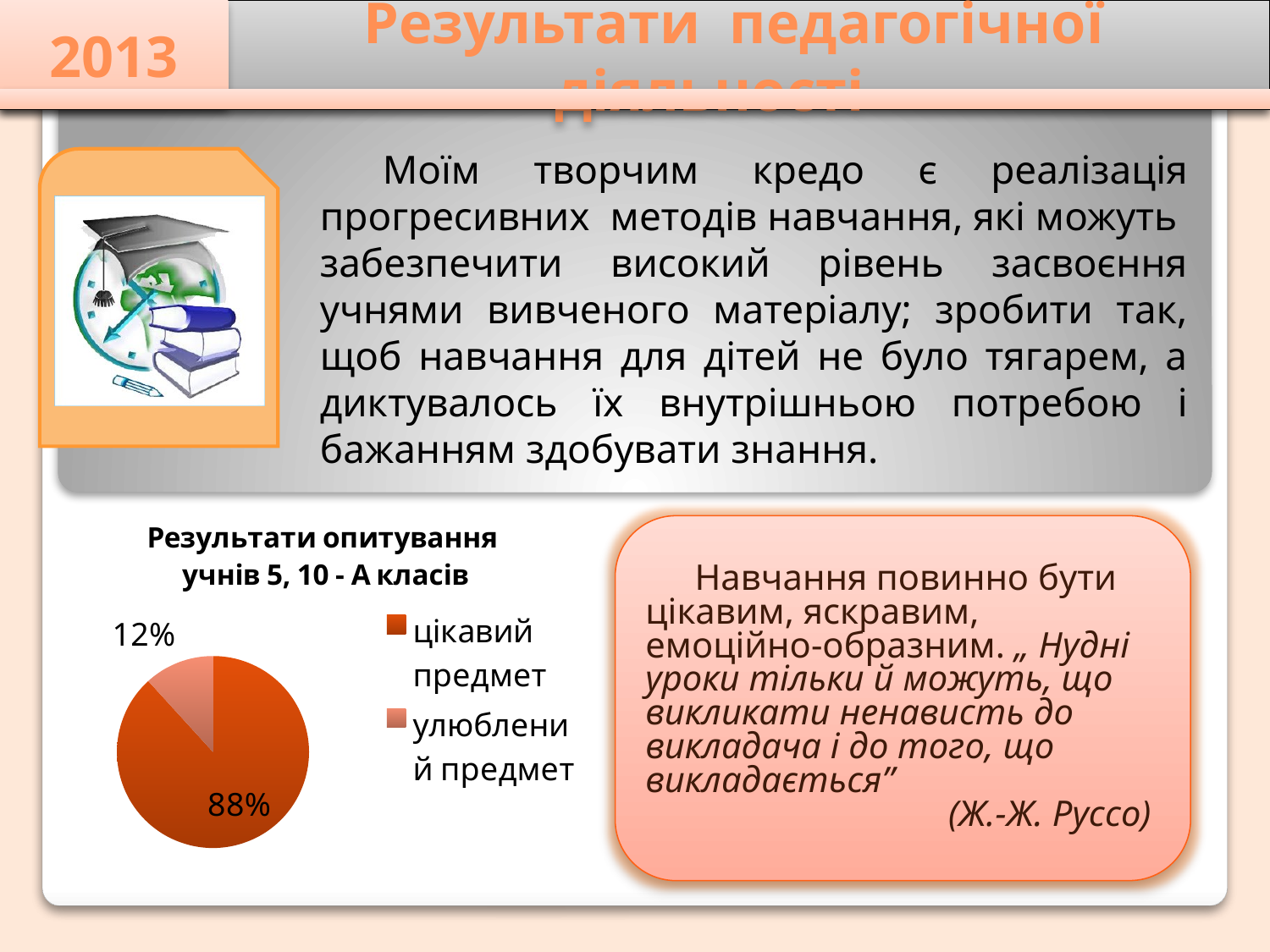
What is the title of the pie chart? Результати опитування учнів 5, 10 - А класів What kind of chart is shown under the title "Результати опитування учнів 5, 10 - А класів"? pie chart Which is larger: the share for "цікавий предмет" or for "улюблений предмет"? цікавий предмет What share of the pie does "цікавий предмет" take? 88% Which slice of the pie chart is the smallest? улюблений предмет What is the difference in percentage points between the "цікавий предмет" and "улюблений предмет" slices? 76 What share of the pie does "улюблений предмет" take? 12% How many entries does the legend of the pie chart list? 2 Which legend entry is shown in the darker orange colour in the pie chart? цікавий предмет How many slices does the pie chart have? 2 Which slice of the pie chart is the largest? цікавий предмет